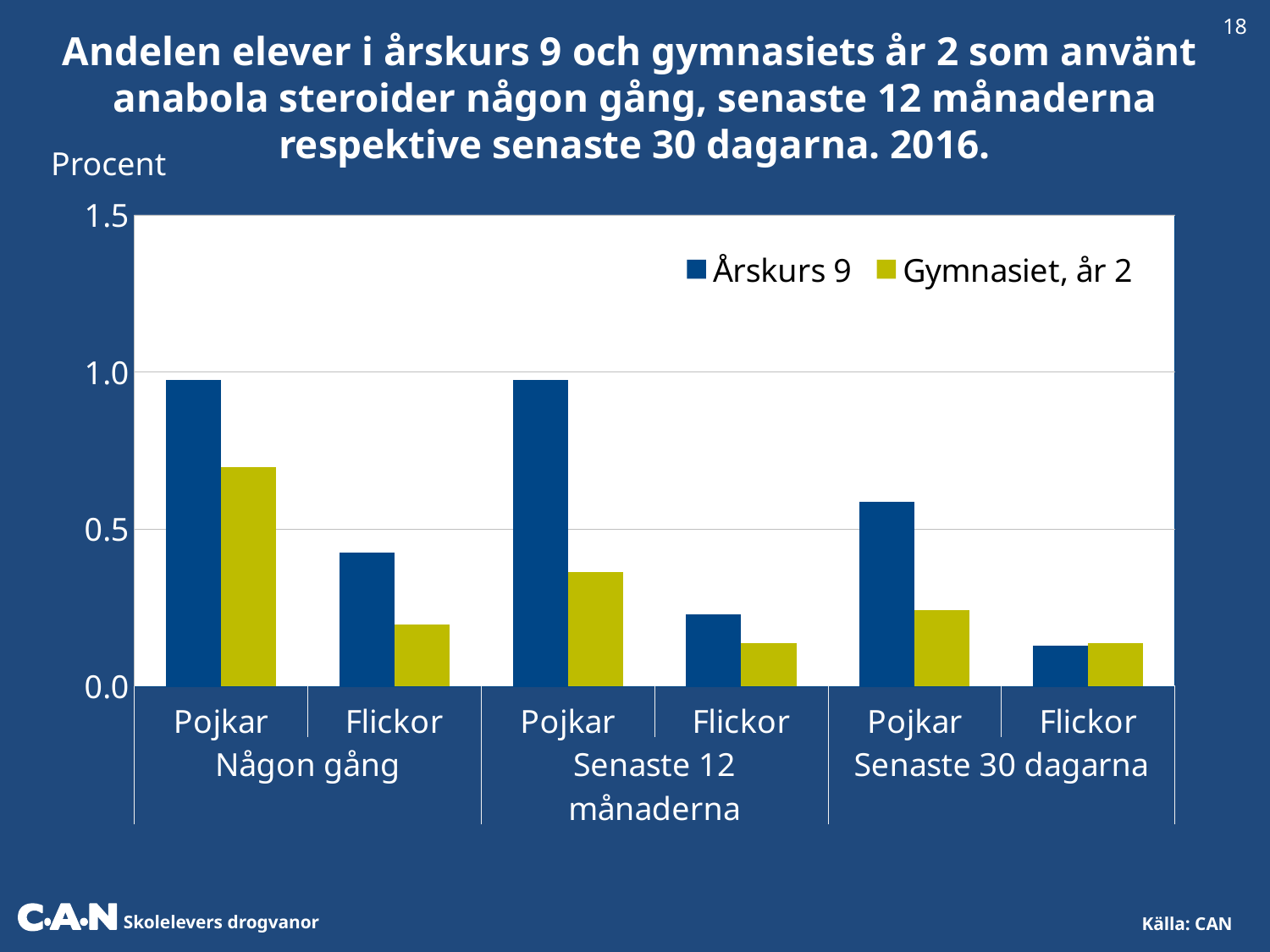
How many time-period groups (Någon gång, Senaste 12 månaderna, Senaste 30 dagarna) are shown on the x axis? 3 For Pojkar under Någon gång, which series has the larger value, Årskurs 9 or Gymnasiet, år 2? Årskurs 9 Is the Gymnasiet, år 2 value for Pojkar under Någon gång greater or less than 0.5? greater What is the label on the vertical axis? Procent Within the Senaste 30 dagarna group, which bar is the highest? Pojkar, Årskurs 9 What are the two series named in the legend? Årskurs 9 and Gymnasiet, år 2 Is the Årskurs 9 value for Pojkar under Senaste 30 dagarna greater or less than 0.5? greater For Flickor under Senaste 12 månaderna, which series has the larger value, Årskurs 9 or Gymnasiet, år 2? Årskurs 9 Is the Årskurs 9 value for Flickor under Någon gång greater or less than 0.5? less How many series does the legend list? 2 What kind of chart is shown on the slide? Bar chart